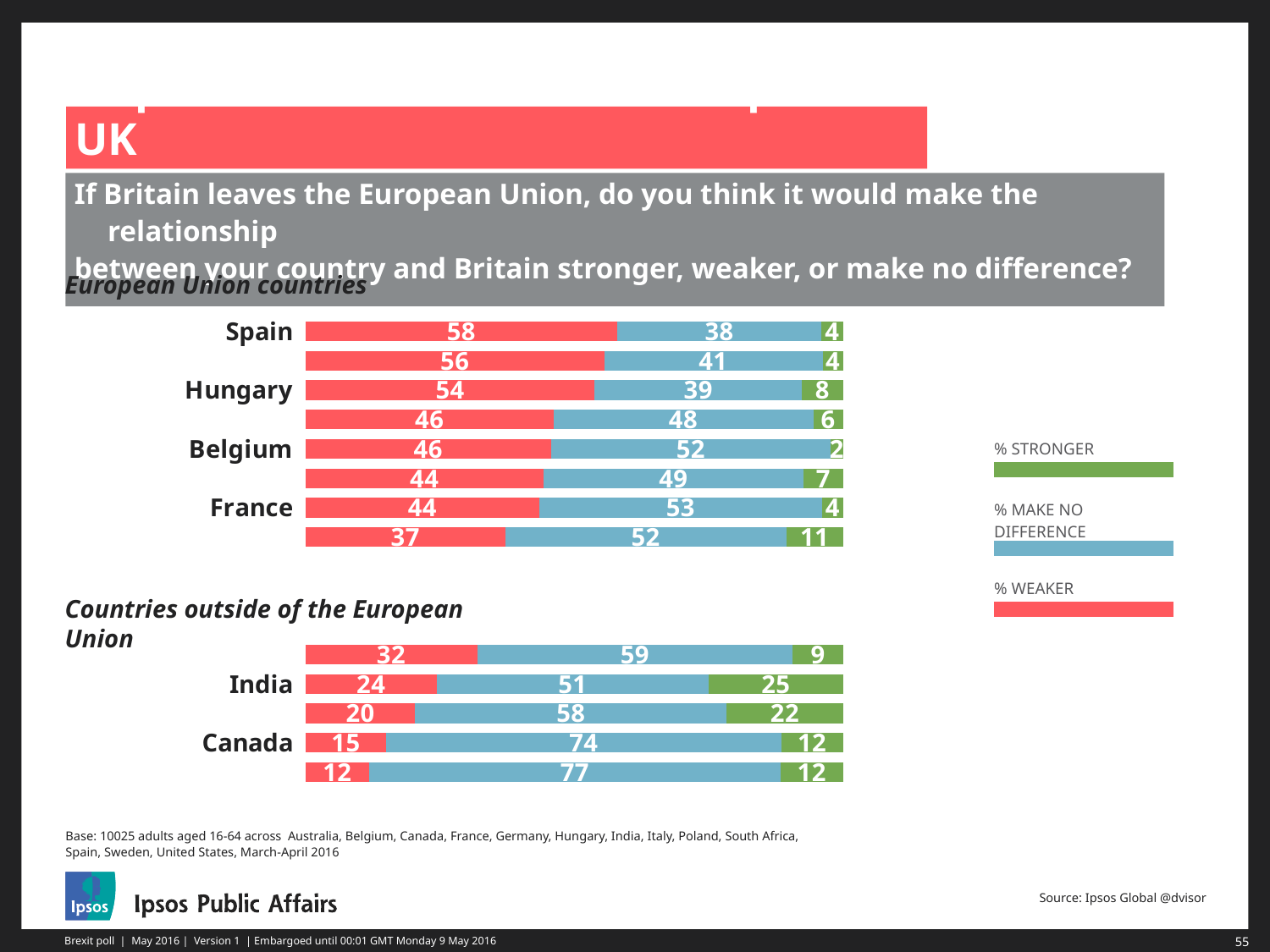
In the European Union countries chart, what is the % STRONGER value for Hungary? 8 In the Countries outside of the European Union chart, which is larger: the % WEAKER value for India or for Canada? India In the European Union countries chart, what is the % MAKE NO DIFFERENCE value for France? 53 In the European Union countries chart, what is the difference between the % WEAKER values for Spain and Hungary? 4 In the European Union countries chart, what is the total of the Belgium bar? 100 In the Countries outside of the European Union chart, what is the % STRONGER value for India? 25 In the European Union countries chart, which of the labelled countries has the lowest % STRONGER value? Belgium What kind of chart is used on this slide? Stacked bar chart In the European Union countries chart, which of the labelled countries has the highest % WEAKER value? Spain In the Countries outside of the European Union chart, what is the % MAKE NO DIFFERENCE value for Canada? 74 In the European Union countries chart, what is the % WEAKER value for Spain? 58 How many series does the legend list? 3